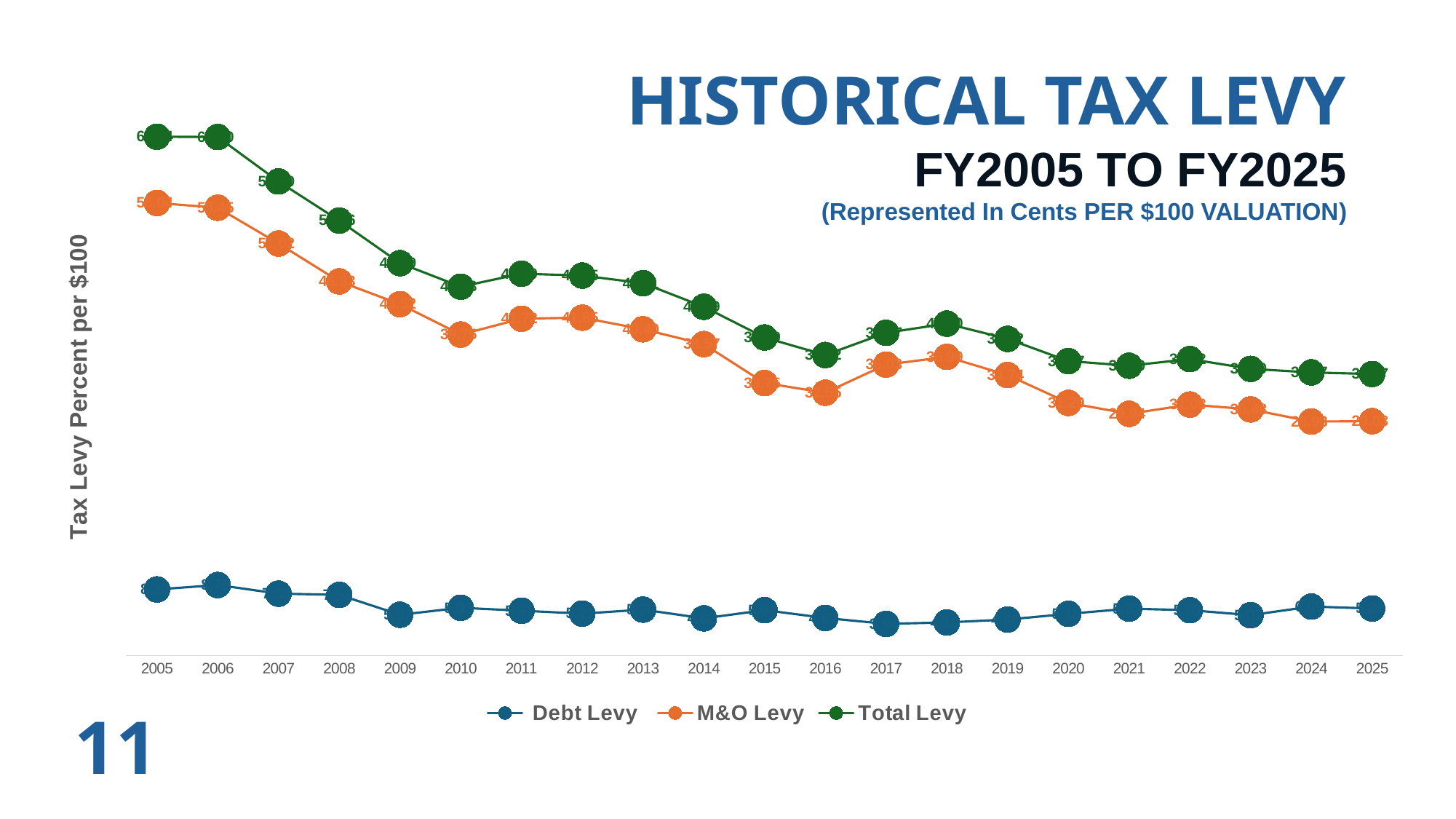
What kind of chart is shown on the slide? line chart What is the title of the chart? HISTORICAL TAX LEVY FY2005 TO FY2025 Is the M&O Levy larger in 2010 or in 2011? 2011 Is the Debt Levy larger in 2006 or in 2017? 2006 How many series does the legend list? 3 Does the M&O Levy generally rise or fall from 2005 to 2025? fall How many years are plotted along the x axis? 21 Which series has the lowest values across all years? Debt Levy Does the Total Levy generally rise or fall from 2005 to 2025? fall Which series has the highest values across all years? Total Levy Is the Total Levy larger in 2005 or in 2025? 2005 Which series is drawn in green? Total Levy